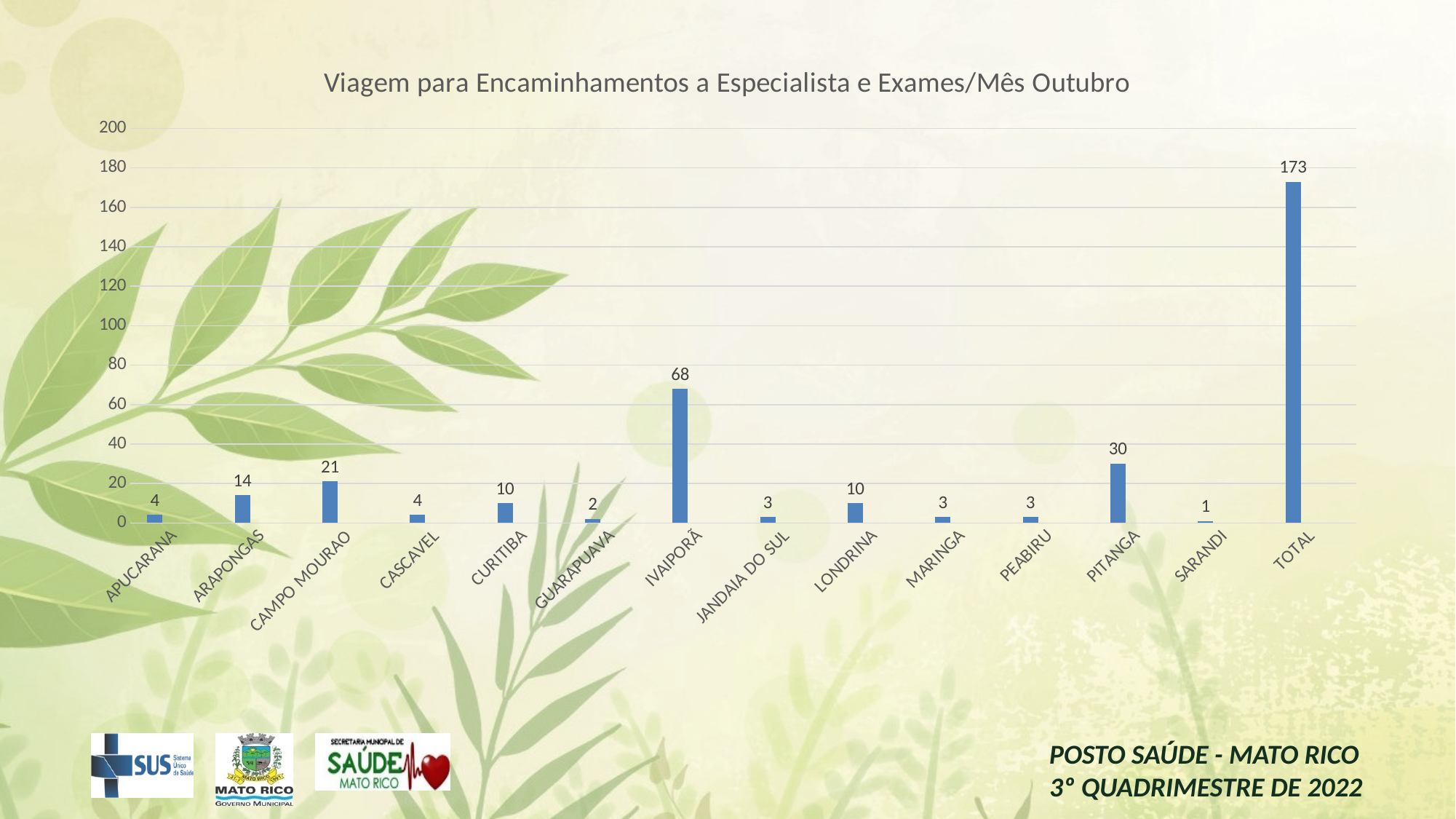
What is the value for IVAIPORÃ? 68 What is the difference between the values for IVAIPORÃ and PITANGA? 38 What is the value shown for the TOTAL bar? 173 How many categories are shown on the x axis? 14 What is the title of the chart? Viagem para Encaminhamentos a Especialista e Exames/Mês Outubro Which category has the lowest value? SARANDI What is the value for CAMPO MOURAO? 21 What is the value for PITANGA? 30 What kind of chart is shown on the slide? Bar chart Which is larger, the value for ARAPONGAS or the value for CURITIBA? ARAPONGAS Is the value for TOTAL greater or less than 160? greater Excluding the TOTAL bar, which city has the highest value? IVAIPORÃ